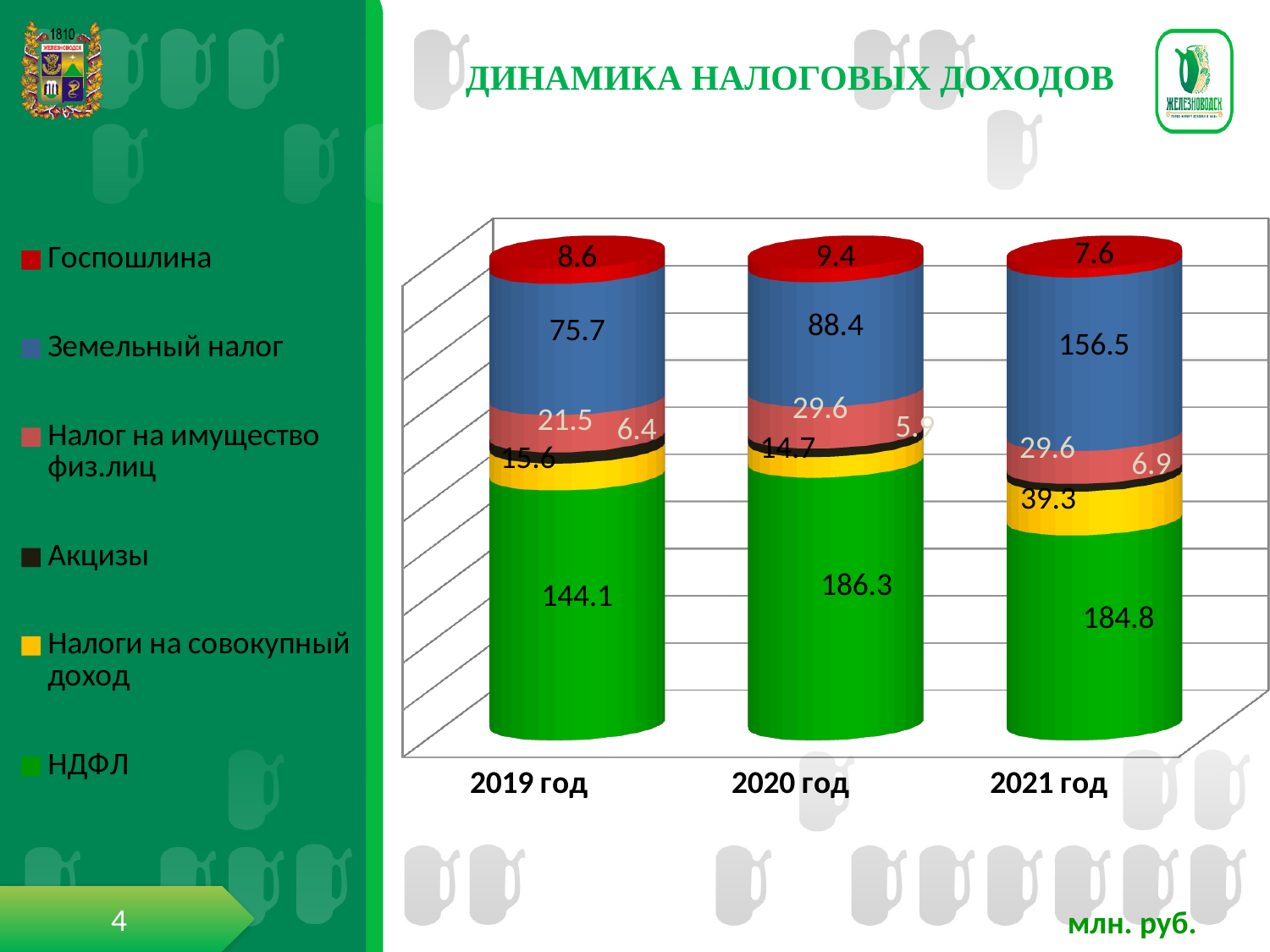
What is the value of Госпошлина for 2020 год? 9.4 What kind of chart is shown on the slide? Stacked bar chart What is the value of Налоги на совокупный доход for 2021 год? 39.3 What is the total of the stacked bar for 2020 год? 334.3 In which year is the Госпошлина value the lowest? 2021 год In which year is the Земельный налог value the highest? 2021 год What is the value of Земельный налог for 2021 год? 156.5 How many series does the legend list? 6 Which is larger: НДФЛ for 2020 год or НДФЛ for 2021 год? 2020 год What is the value of НДФЛ for 2019 год? 144.1 What is the difference between the Земельный налог values for 2021 год and 2020 год? 68.1 How many years are shown on the x axis? 3